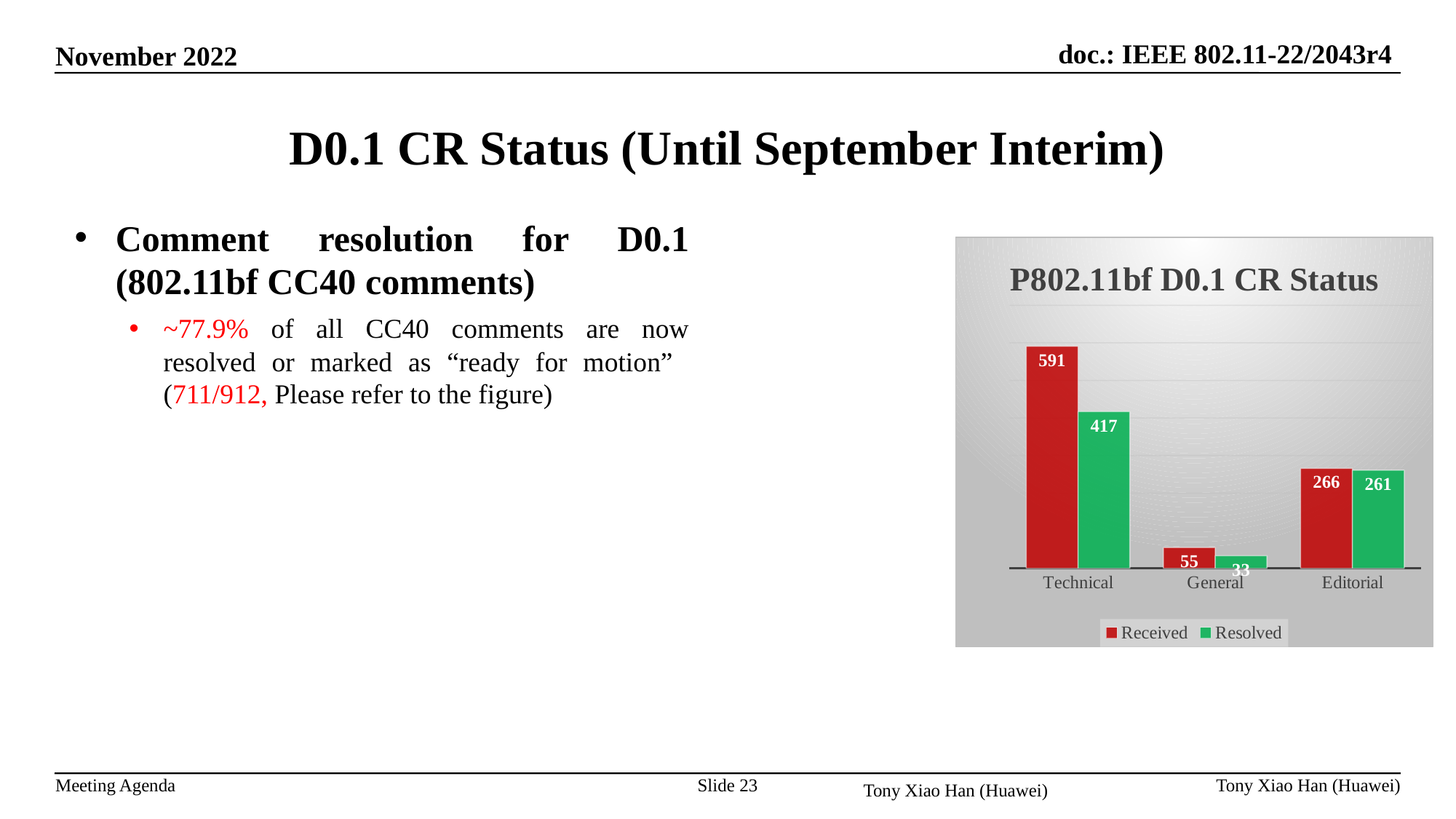
What is the difference between Received and Resolved for Technical? 174 How many categories are shown on the x axis? 3 Which category has the lowest Resolved value? General What kind of chart is shown? bar chart How many series does the legend list? 2 Which is larger, the Received value for Editorial or the Resolved value for Technical? Resolved value for Technical What is the Resolved value for General? 33 Which category has the highest Received value? Technical What is the Resolved value for Editorial? 261 What is the Received value for Technical? 591 What is the difference between Received and Resolved for General? 22 What is the title of the chart? P802.11bf D0.1 CR Status